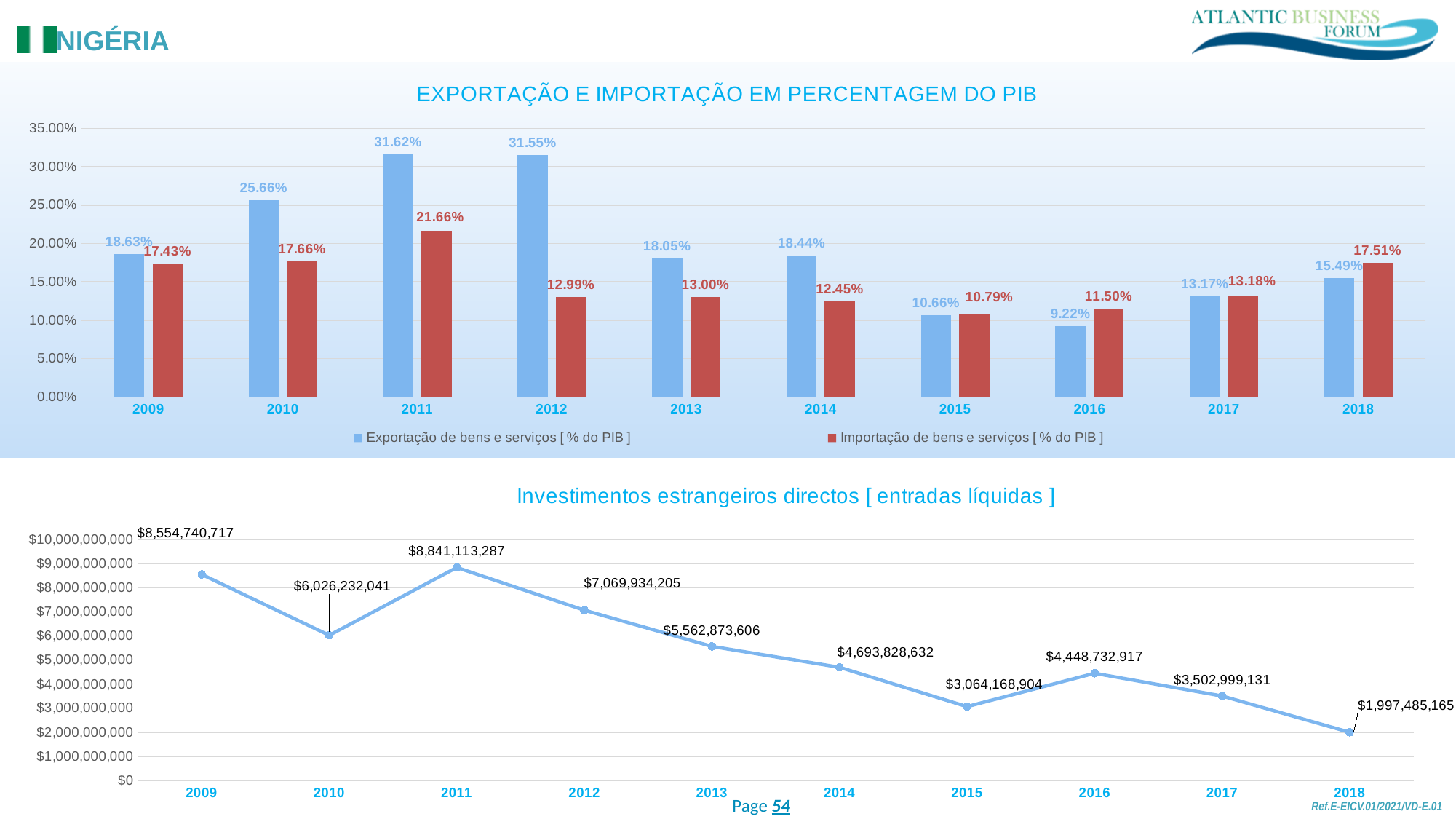
In the chart 'EXPORTAÇÃO E IMPORTAÇÃO EM PERCENTAGEM DO PIB', how many series does the legend list? 2 In the chart 'EXPORTAÇÃO E IMPORTAÇÃO EM PERCENTAGEM DO PIB', which year has the lowest Exportação de bens e serviços value? 2016 In the chart 'EXPORTAÇÃO E IMPORTAÇÃO EM PERCENTAGEM DO PIB', which is larger in 2018: Exportação or Importação? Importação In the chart 'EXPORTAÇÃO E IMPORTAÇÃO EM PERCENTAGEM DO PIB', which year has the highest Importação de bens e serviços value? 2011 In the chart 'Investimentos estrangeiros directos [ entradas líquidas ]', do the values generally rise or fall from 2011 to 2015? Fall In the chart 'EXPORTAÇÃO E IMPORTAÇÃO EM PERCENTAGEM DO PIB', what is the difference between Exportação and Importação in 2012? 18.56% In the chart 'Investimentos estrangeiros directos [ entradas líquidas ]', how many years are plotted? 10 In the chart 'Investimentos estrangeiros directos [ entradas líquidas ]', what is the value for 2015? $3,064,168,904 What kind of chart is 'Investimentos estrangeiros directos [ entradas líquidas ]'? Line chart In the chart 'Investimentos estrangeiros directos [ entradas líquidas ]', which year has the highest value? 2011 In the chart 'EXPORTAÇÃO E IMPORTAÇÃO EM PERCENTAGEM DO PIB', what is the value of Importação de bens e serviços for 2012? 12.99% In the chart 'EXPORTAÇÃO E IMPORTAÇÃO EM PERCENTAGEM DO PIB', what is the value of Exportação de bens e serviços for 2011? 31.62%